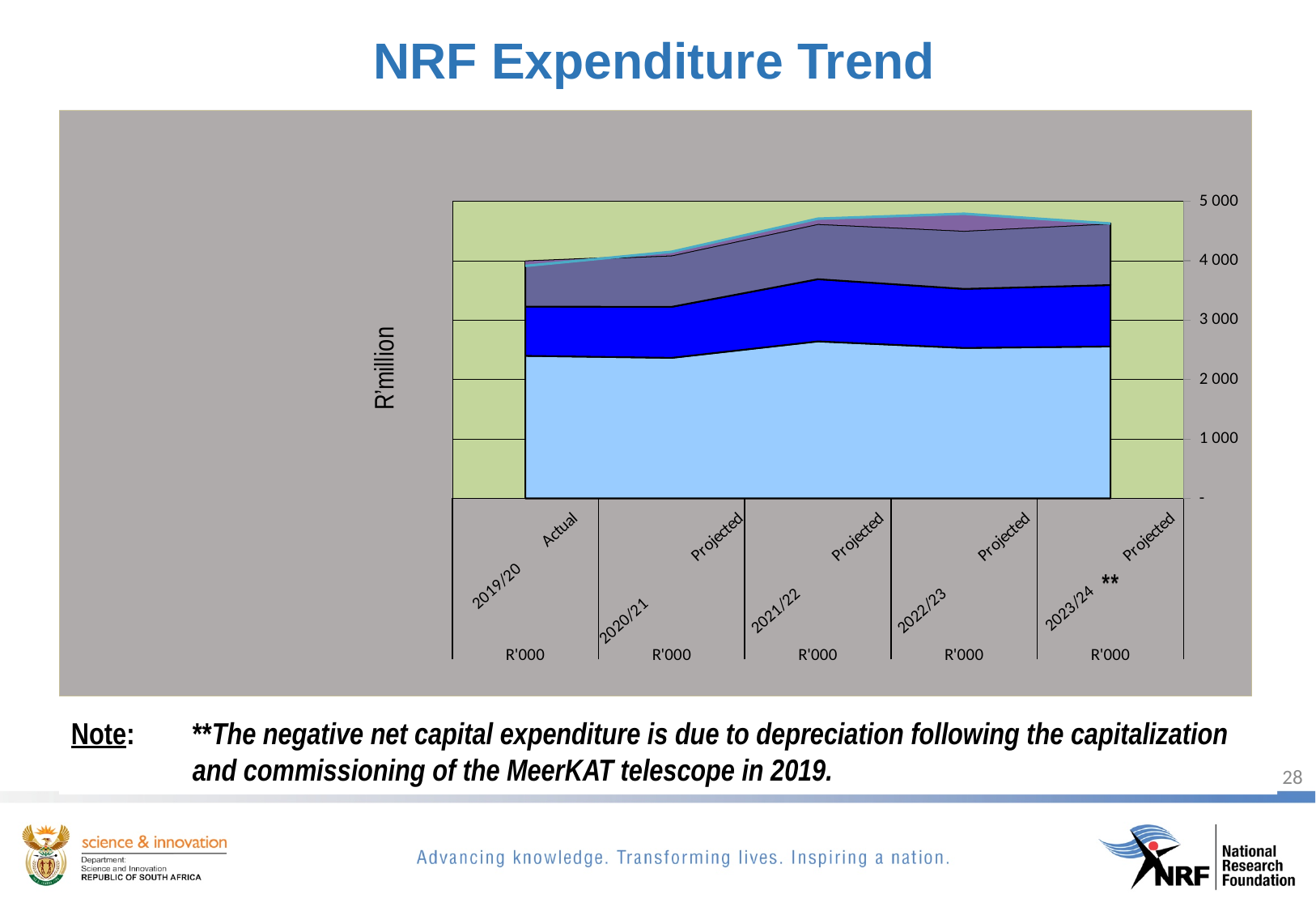
How many financial years are shown on the x axis of the chart? 5 Is the bottom (light blue) layer for 2019/20 greater or less than 2 000? greater Is the total expenditure for 2021/22 greater or less than 4 000? greater Does the total expenditure rise or fall from 2019/20 to 2021/22? rise What kind of chart is shown on the slide? Stacked area chart Is the bottom (light blue) layer for 2021/22 greater or less than 3 000? less Which year is labelled as Actual rather than Projected? 2019/20 What is the label on the vertical axis of the chart? R'million Which financial year has the lowest total expenditure? 2019/20 What is the title of the chart on the slide? NRF Expenditure Trend